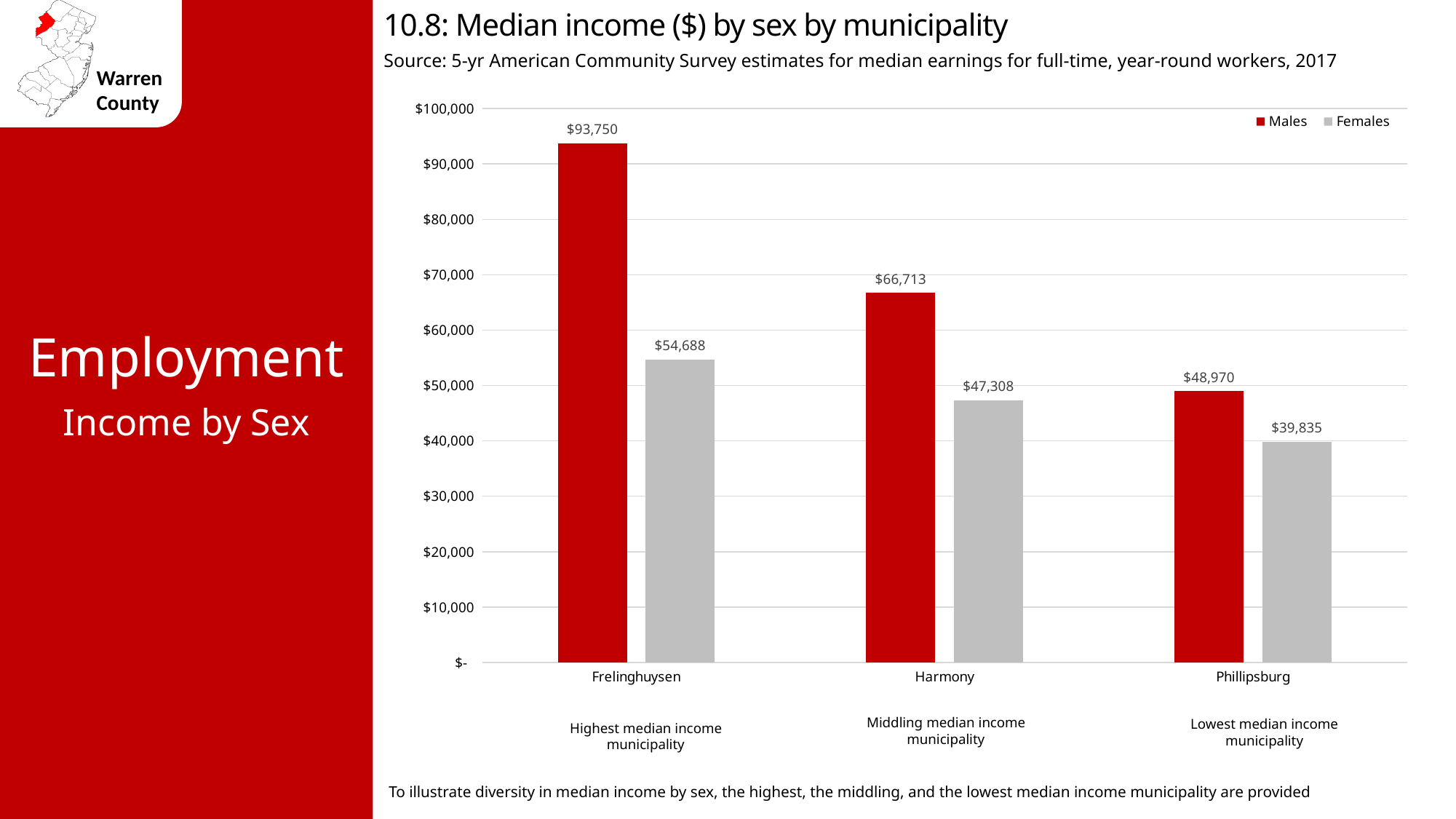
What is the difference between male and female median income in Frelinghuysen? $39,062 How many municipalities are shown on the chart? 3 What is the median income for females in Harmony? $47,308 Which is larger: the median income for females in Frelinghuysen or for males in Phillipsburg? Females in Frelinghuysen Which municipality has the highest median income for males? Frelinghuysen What kind of chart is shown on the slide? Bar chart What is the median income for females in Phillipsburg? $39,835 How many series does the legend list? 2 What is the median income for males in Frelinghuysen? $93,750 Is the median income for males in Harmony greater or less than $60,000? greater Which municipality has the lowest median income for females? Phillipsburg What is the difference between male and female median income in Phillipsburg? $9,135